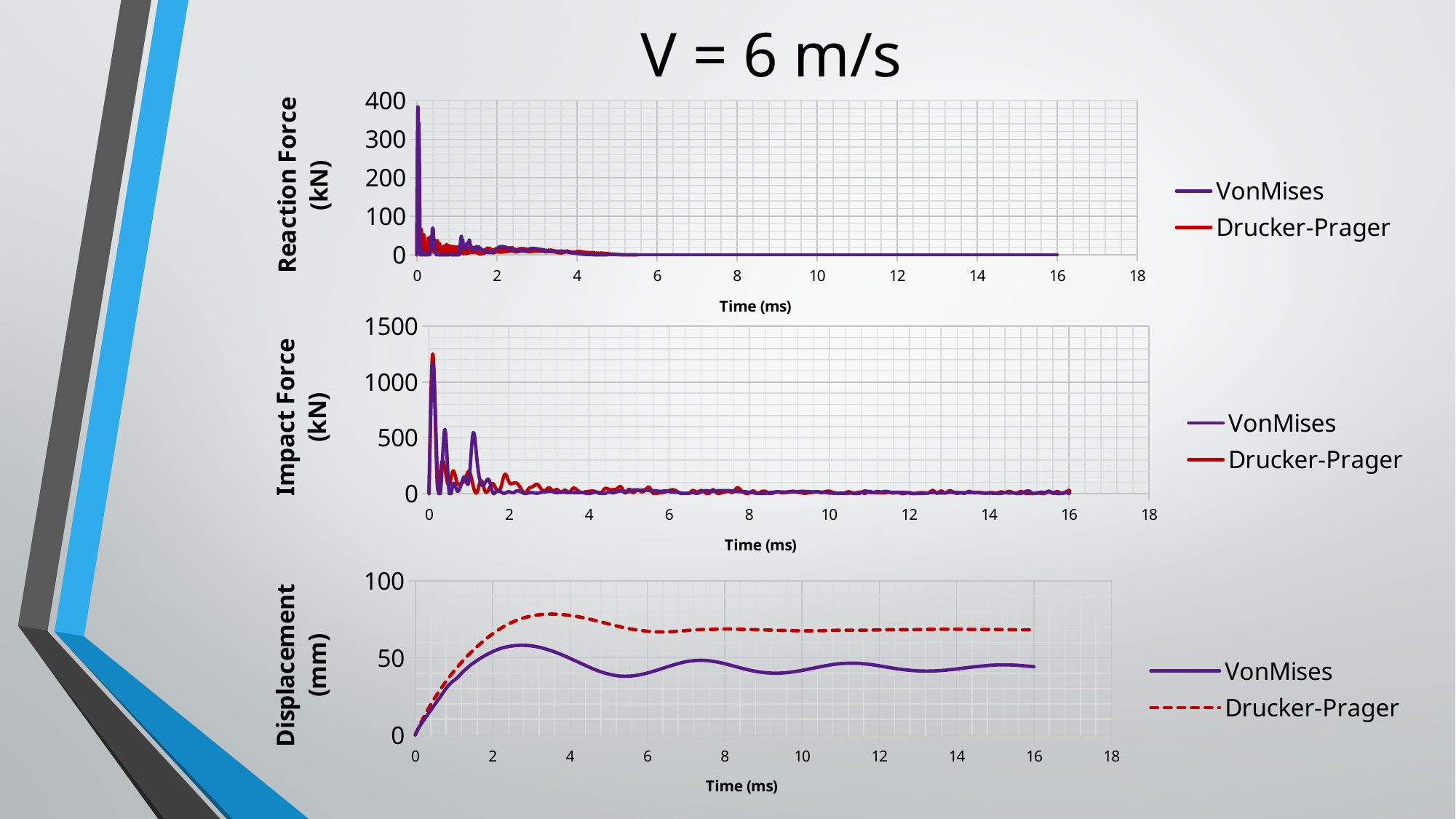
In the Displacement chart, which series reaches the higher peak, VonMises or Drucker-Prager? Drucker-Prager In the Displacement chart, is the Drucker-Prager value at 16 ms greater or less than 50? greater In the Displacement chart, is the VonMises value at 16 ms greater or less than 50? less In the Displacement chart, which series has the higher value at 16 ms, VonMises or Drucker-Prager? Drucker-Prager How many series does the legend of the Impact Force chart list? 2 What kind of chart is the Reaction Force chart at the top of the slide? line chart In the Displacement chart, does the VonMises line rise or fall between 0 and 2 ms? rise In the Reaction Force chart, is the peak value greater or less than 300? greater What are the two series named in the legend of the Displacement chart? VonMises and Drucker-Prager What is the x-axis label shared by all three charts on the slide? Time (ms)